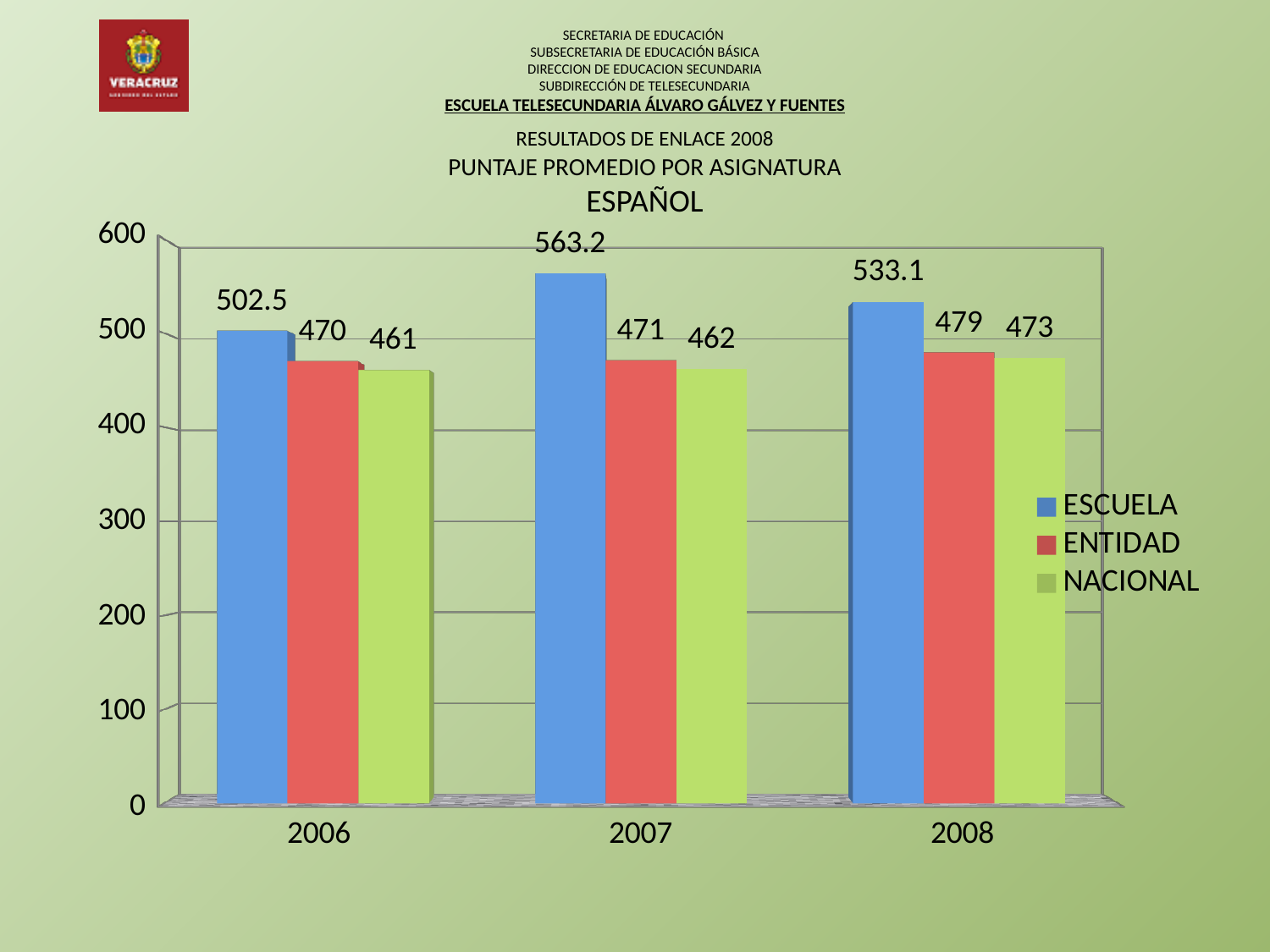
What kind of chart is shown? bar chart How many series does the legend list? 3 Which series is shown in red in the legend? ENTIDAD In which year is the ESCUELA value highest? 2007 What is the difference between the ESCUELA and ENTIDAD values in 2007? 92.2 Does the ENTIDAD value rise or fall from 2006 to 2008? rise In which year is the NACIONAL value lowest? 2006 Which is larger in 2008, the ESCUELA value or the NACIONAL value? ESCUELA What is the NACIONAL value for 2006? 461 What is the ESCUELA value for 2007? 563.2 What is the ENTIDAD value for 2008? 479 How many years are shown on the x axis? 3